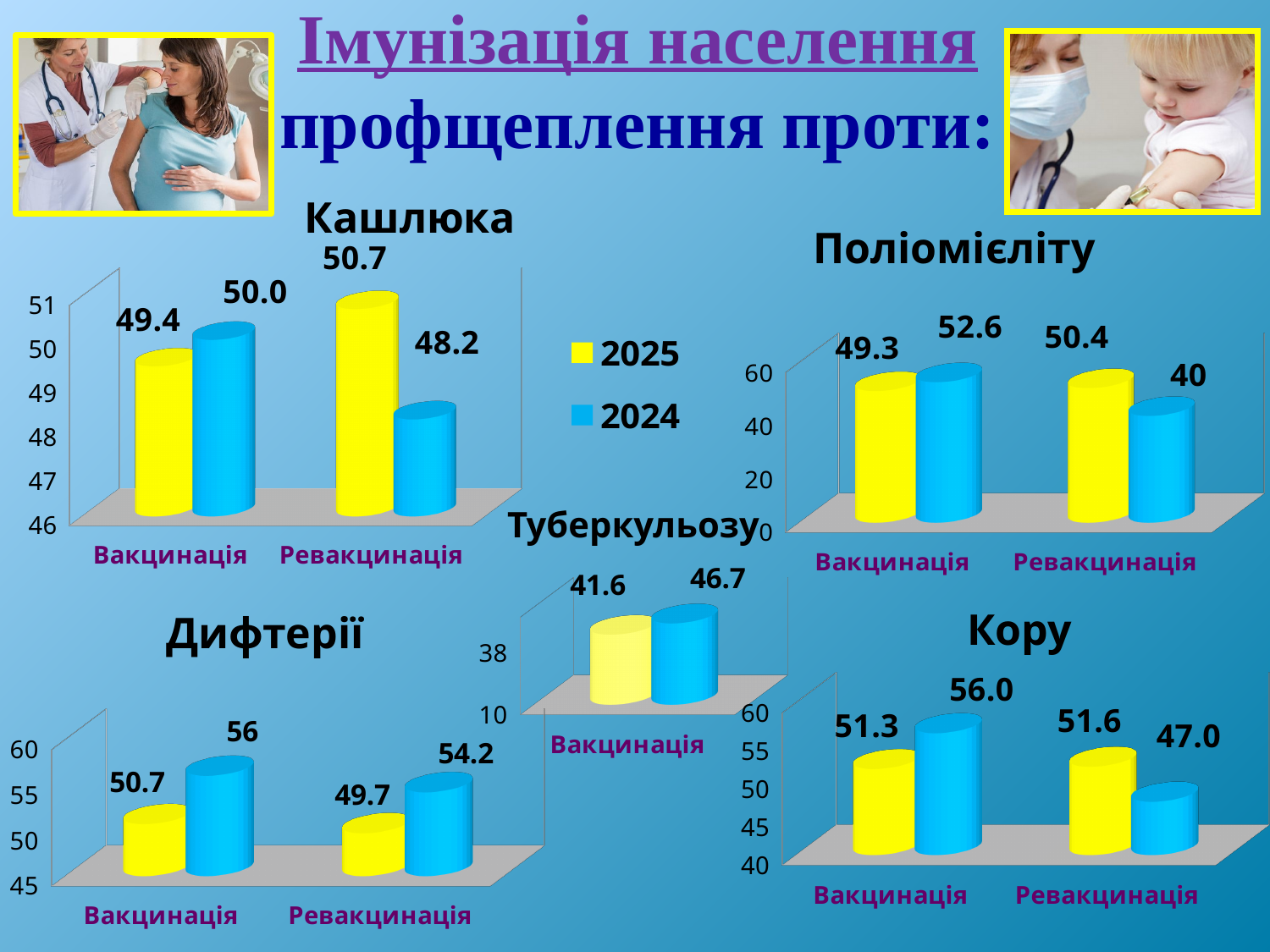
In the Кашлюка chart, what is the value for Ревакцинація in 2024? 48.2 In the Кору chart, what is the value for Ревакцинація in 2024? 47.0 In the Туберкульозу chart, which year has the larger value for Вакцинація, 2025 or 2024? 2024 In the Кашлюка chart, what is the value for Вакцинація in 2025? 49.4 In the Поліомієліту chart, what is the difference between the 2024 and 2025 values for Вакцинація? 3.3 What kind of chart is the Кашлюка chart? Bar chart In the Дифтерії chart, what is the difference between the 2024 and 2025 values for Ревакцинація? 4.5 In the Поліомієліту chart, what is the value for Ревакцинація in 2024? 40 In the Туберкульозу chart, what is the value for Вакцинація in 2025? 41.6 How many series does the legend list? 2 In the Кору chart, which category and year has the highest value? Вакцинація, 2024 (56.0) In the Дифтерії chart, what is the value for Вакцинація in 2024? 56